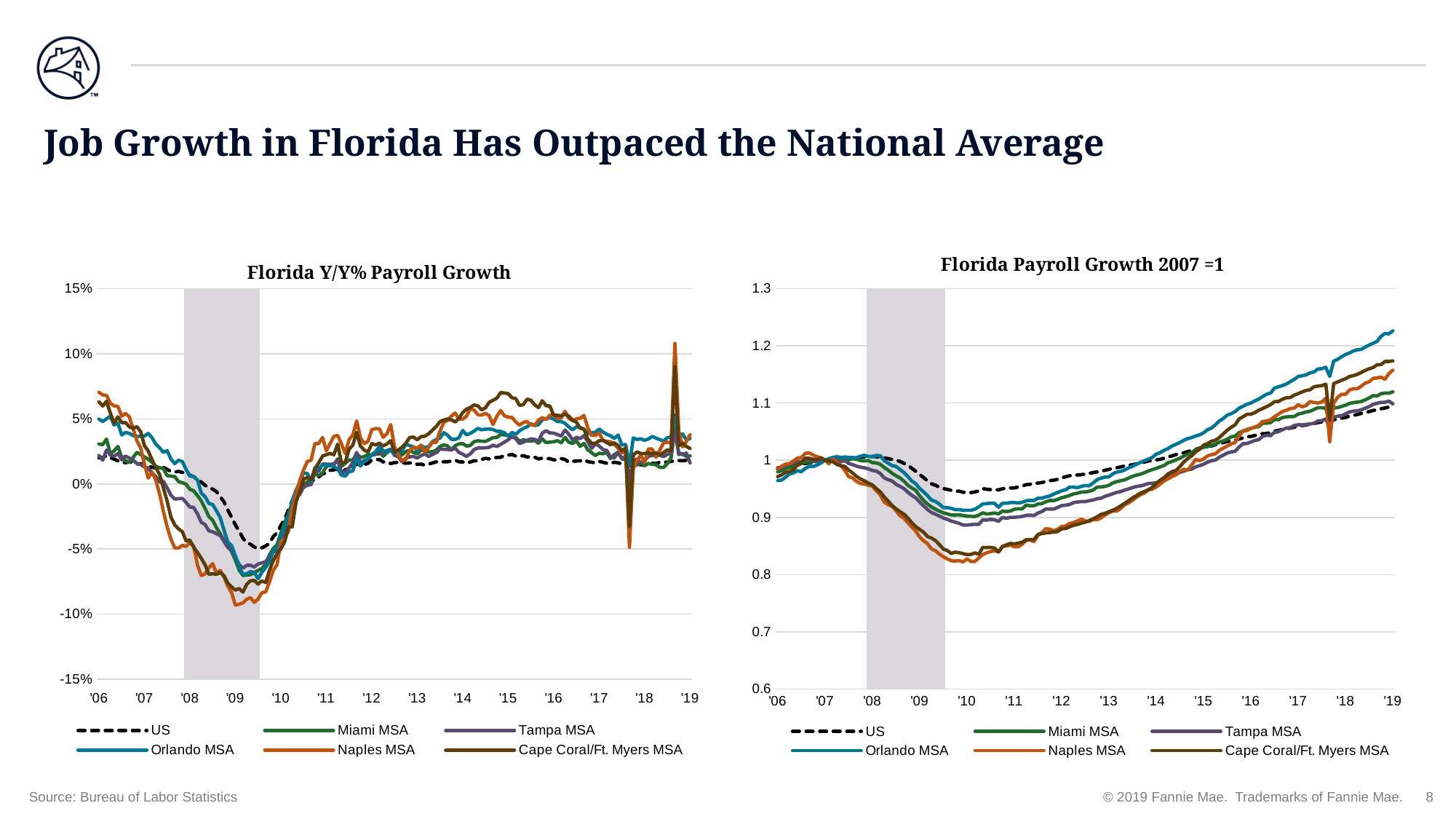
In the right chart "Florida Payroll Growth 2007 =1", does the Orlando MSA line rise or fall from '10 to '19? Rises In the right chart "Florida Payroll Growth 2007 =1", which series has the highest value at '19? Orlando MSA How many series does the legend of the right chart "Florida Payroll Growth 2007 =1" list? 6 What kind of chart is the left chart titled "Florida Y/Y% Payroll Growth"? Line chart What is the title of the right chart? Florida Payroll Growth 2007 =1 Which series is drawn as a dashed line in the left chart "Florida Y/Y% Payroll Growth"? US In the right chart "Florida Payroll Growth 2007 =1", is the value for Orlando MSA at '19 greater or less than 1.2? greater In the left chart "Florida Y/Y% Payroll Growth", is the value for Naples MSA at '09 greater or less than -5%? less In the right chart "Florida Payroll Growth 2007 =1", which is larger at '10: the value for US or the value for Naples MSA? US In the left chart "Florida Y/Y% Payroll Growth", does the US line rise or fall from '08 to '09? Falls In the right chart "Florida Payroll Growth 2007 =1", is the value for Naples MSA at '10 greater or less than 0.9? less